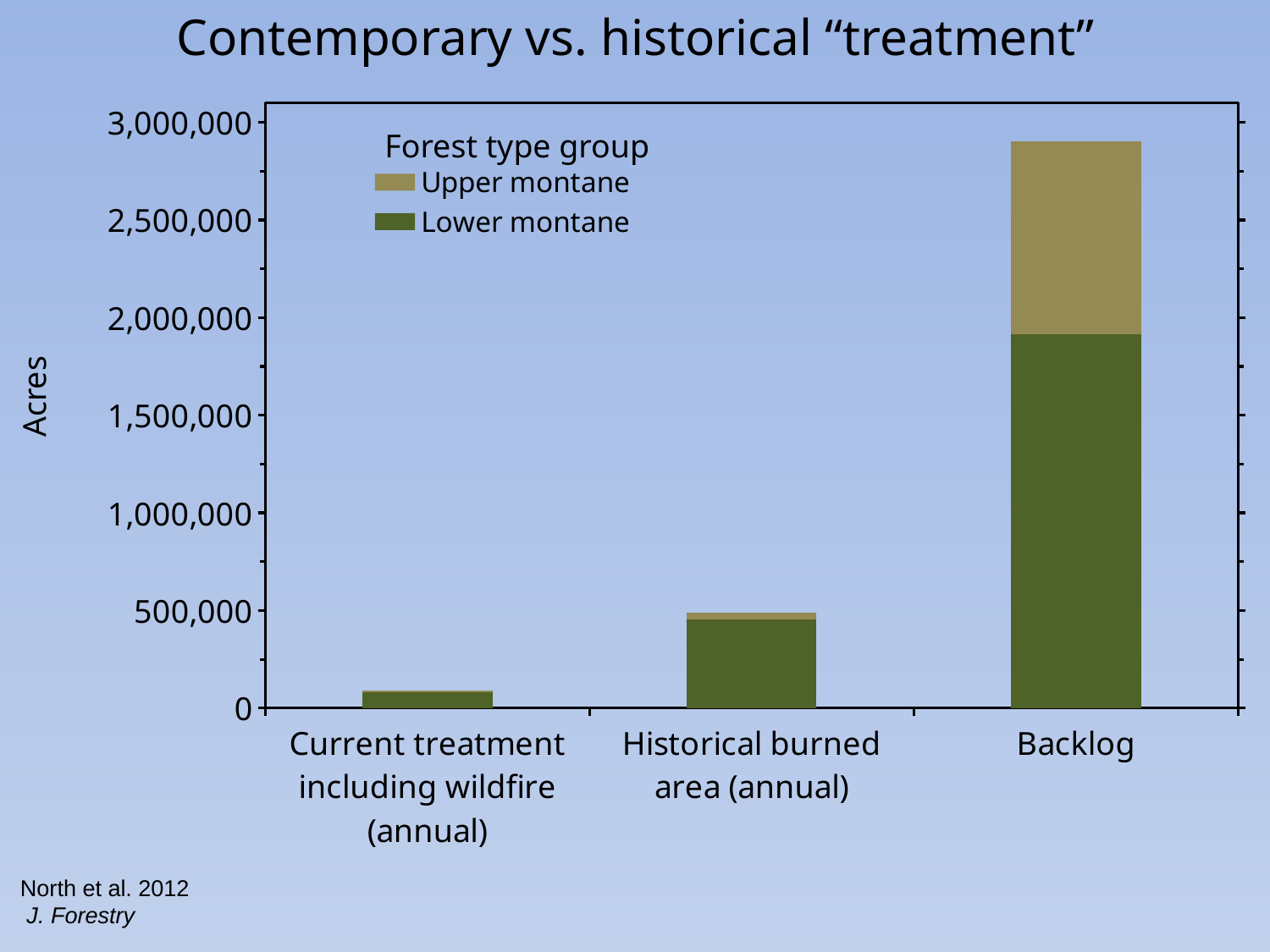
What is the label on the y axis of the chart? Acres Which category has the highest total acres? Backlog How many series does the chart's legend list? 2 Which is larger, the total for Backlog or the total for Historical burned area (annual)? Backlog Is the total value for Current treatment including wildfire (annual) greater or less than 500,000? less Which category has the lowest total acres? Current treatment including wildfire (annual) In the Backlog bar, which is larger, the Lower montane segment or the Upper montane segment? Lower montane How many categories are shown on the x axis of the chart? 3 What kind of chart is shown on the slide? Stacked bar chart Is the total value for Backlog greater or less than 2,500,000? greater Is the total value for Historical burned area (annual) greater or less than 1,000,000? less Do the total values rise or fall moving from left to right along the x axis? rise